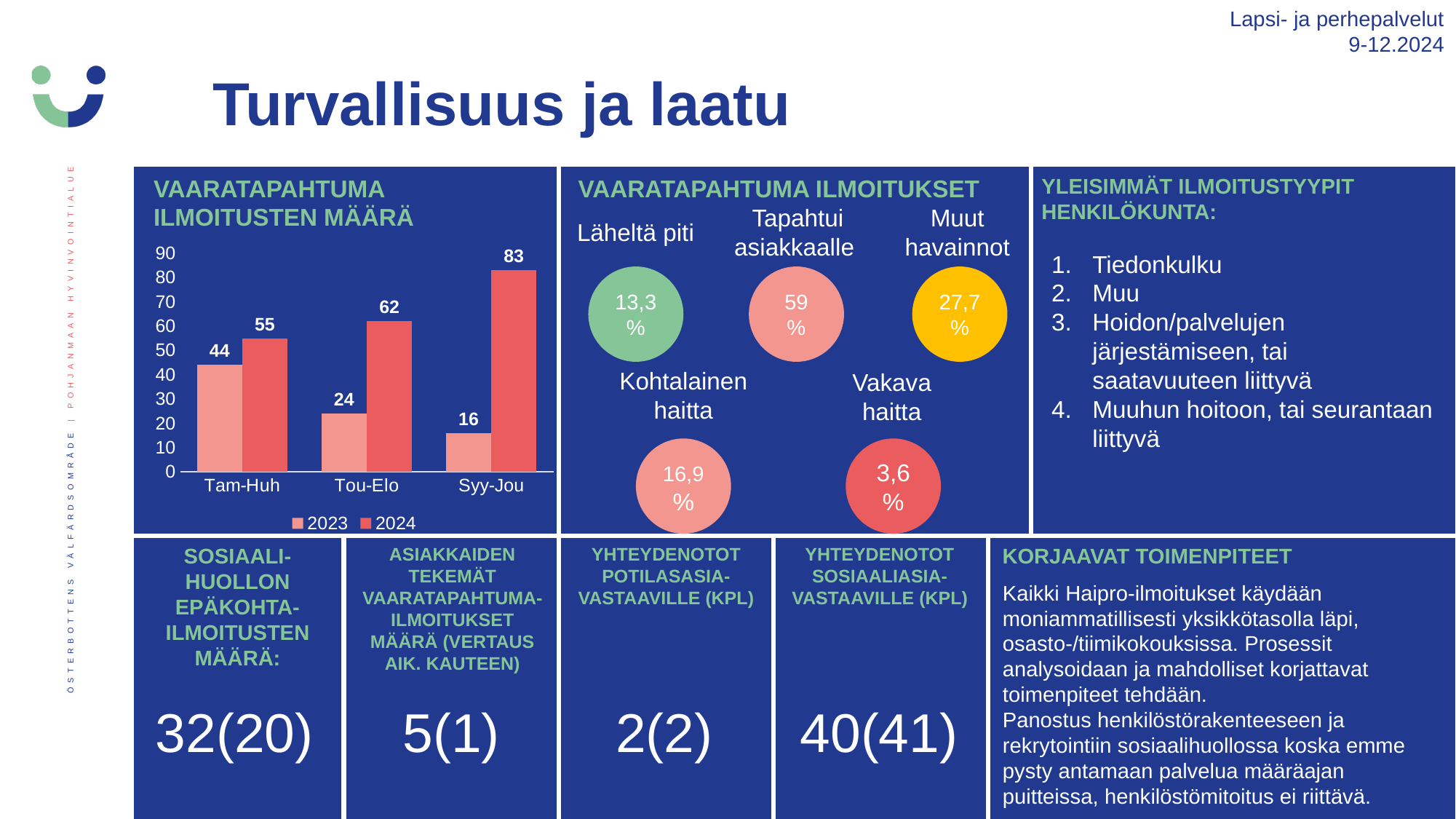
In the 'VAARATAPAHTUMA ILMOITUSTEN MÄÄRÄ' chart, which category has the lowest 2023 value? Syy-Jou In the 'VAARATAPAHTUMA ILMOITUSTEN MÄÄRÄ' chart, how many series does the legend list? 2 In the 'VAARATAPAHTUMA ILMOITUSTEN MÄÄRÄ' chart, what is the 2024 value for Syy-Jou? 83 In the 'VAARATAPAHTUMA ILMOITUSTEN MÄÄRÄ' chart, what is the difference between the 2024 and 2023 values for Syy-Jou? 67 In the 'VAARATAPAHTUMA ILMOITUSTEN MÄÄRÄ' chart, do the 2023 values rise or fall from Tam-Huh to Syy-Jou? Fall In the 'VAARATAPAHTUMA ILMOITUSTEN MÄÄRÄ' chart, which is larger for Tou-Elo: the 2023 value or the 2024 value? 2024 In the 'VAARATAPAHTUMA ILMOITUSTEN MÄÄRÄ' chart, what is the 2023 value for Tam-Huh? 44 In the 'VAARATAPAHTUMA ILMOITUSTEN MÄÄRÄ' chart, what is the difference between the 2024 values for Syy-Jou and Tam-Huh? 28 In the 'VAARATAPAHTUMA ILMOITUSTEN MÄÄRÄ' chart, what is the 2024 value for Tou-Elo? 62 What type of chart is 'VAARATAPAHTUMA ILMOITUSTEN MÄÄRÄ'? Bar chart In the 'VAARATAPAHTUMA ILMOITUSTEN MÄÄRÄ' chart, which category has the highest 2024 value? Syy-Jou In the 'VAARATAPAHTUMA ILMOITUSTEN MÄÄRÄ' chart, how many categories are shown on the x axis? 3